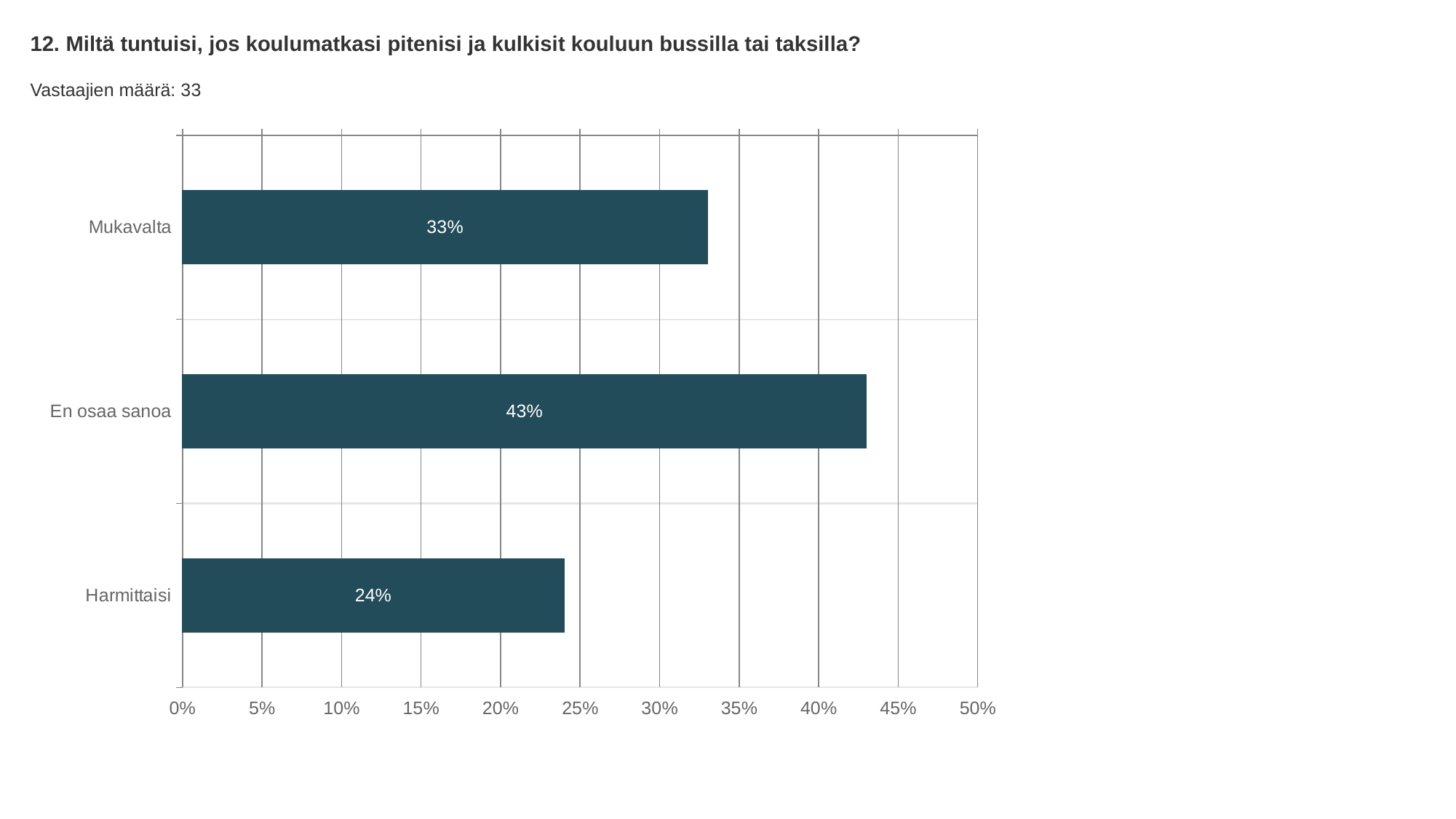
Which category has the lowest value? Harmittaisi Which is larger, the value for Mukavalta or the value for Harmittaisi? Mukavalta What is the difference between the values for En osaa sanoa and Mukavalta? 10% Is the value for En osaa sanoa greater or less than 40%? greater How many categories are shown in the chart? 3 Which category has the highest value? En osaa sanoa How many respondents (Vastaajien määrä) does the slide report? 33 What kind of chart is shown on the slide? Bar chart What is the value for Harmittaisi? 24% What is the value for En osaa sanoa? 43% What is the difference between the values for Mukavalta and Harmittaisi? 9% What is the value for Mukavalta? 33%